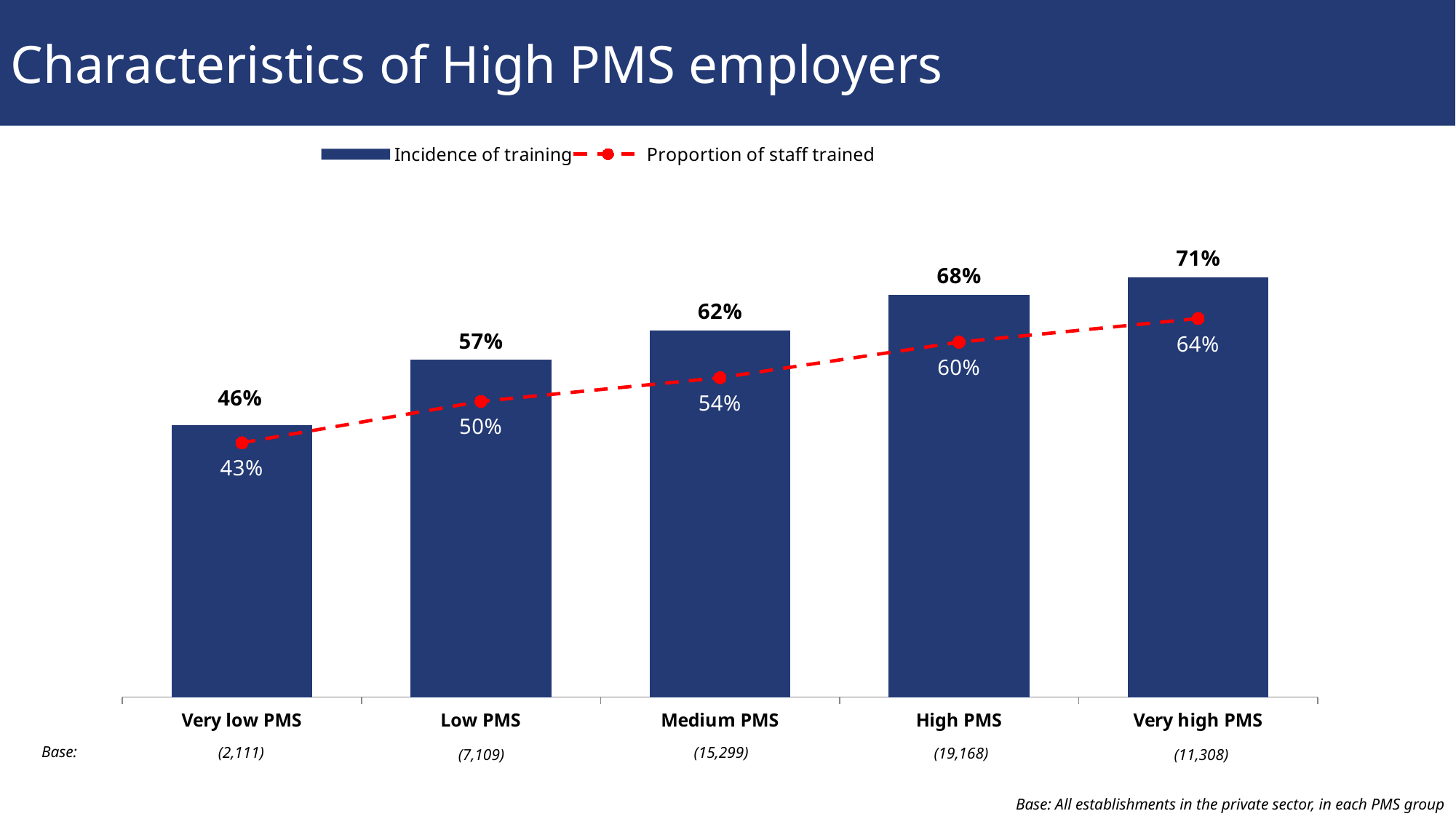
What kind of chart is used to show the incidence of training? Bar chart How many PMS groups are shown on the x axis? 5 Does the proportion of staff trained rise or fall from Very low PMS to Very high PMS? Rise What is the difference between the incidence of training and the proportion of staff trained for High PMS employers? 8 percentage points What is the proportion of staff trained for Very low PMS employers? 43% Which is larger: the incidence of training for Low PMS or the proportion of staff trained for Medium PMS? Incidence of training for Low PMS What is the difference in incidence of training between Very high PMS and Very low PMS employers? 25 percentage points What is the incidence of training for Medium PMS employers? 62% How many series does the legend list? 2 Which PMS group has the lowest proportion of staff trained? Very low PMS What is the proportion of staff trained for Very high PMS employers? 64% Which PMS group has the highest incidence of training? Very high PMS